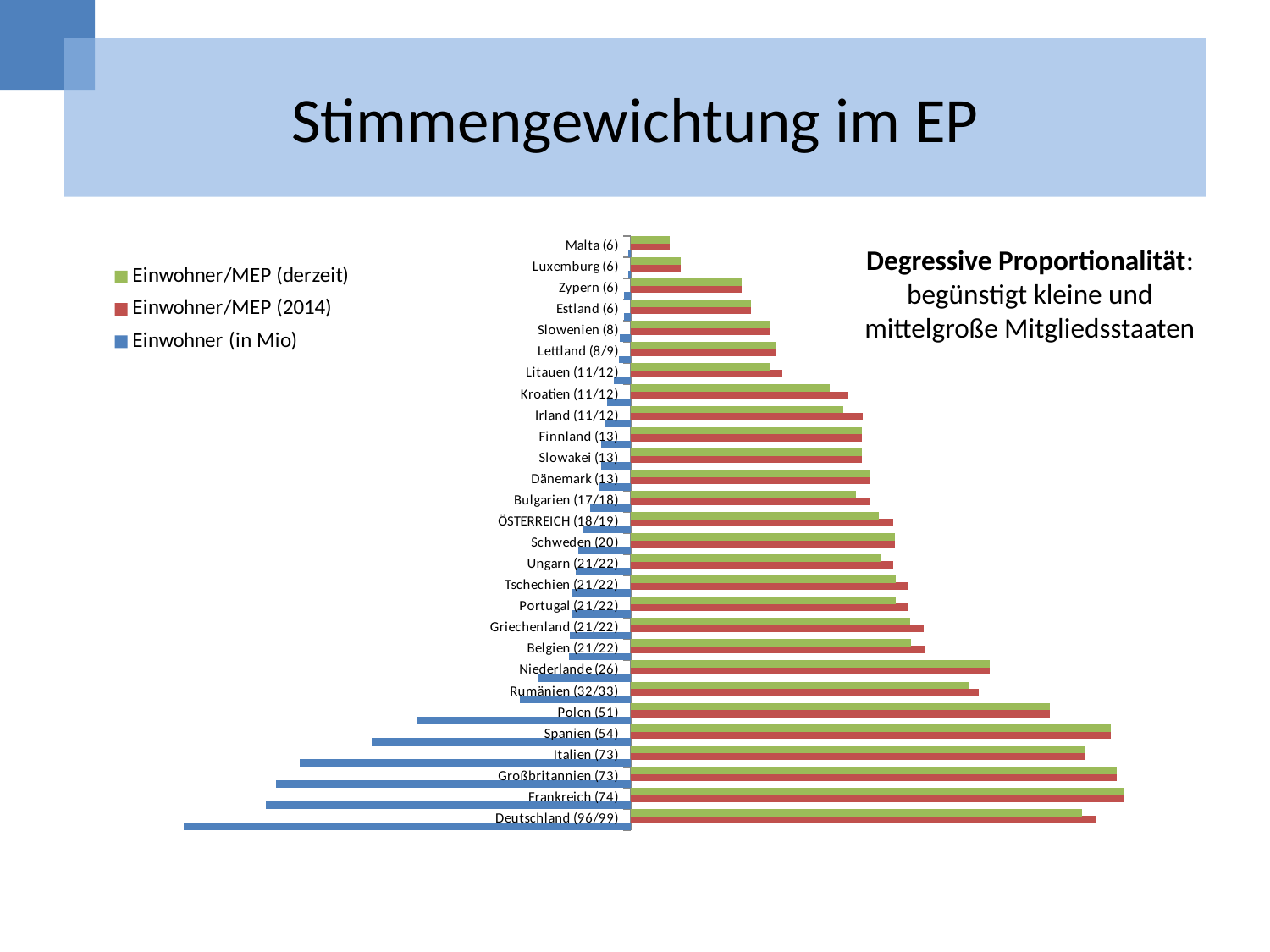
Going from Malta at the top to Deutschland at the bottom, do the Einwohner/MEP (derzeit) bars generally get longer or shorter? Longer Which country has the lowest value for the Einwohner/MEP (derzeit) series? Malta (6) How many series does the chart's legend list? 3 For the Einwohner/MEP (derzeit) series, which is larger: Polen (51) or Spanien (54)? Spanien (54) What colour represents the Einwohner (in Mio) series in the chart? Blue For the Einwohner (in Mio) series, which is larger: Frankreich (74) or Deutschland (96/99)? Deutschland (96/99) How many countries (categories) are plotted in the chart? 28 Which country has the lowest value for the Einwohner/MEP (2014) series? Malta (6) Which country has the lowest value for the Einwohner (in Mio) series? Malta (6) What kind of chart is shown on the slide? Bar chart Which country has the highest value for the Einwohner (in Mio) series? Deutschland (96/99) For the Einwohner/MEP (derzeit) series, which is larger: Niederlande (26) or Belgien (21/22)? Niederlande (26)